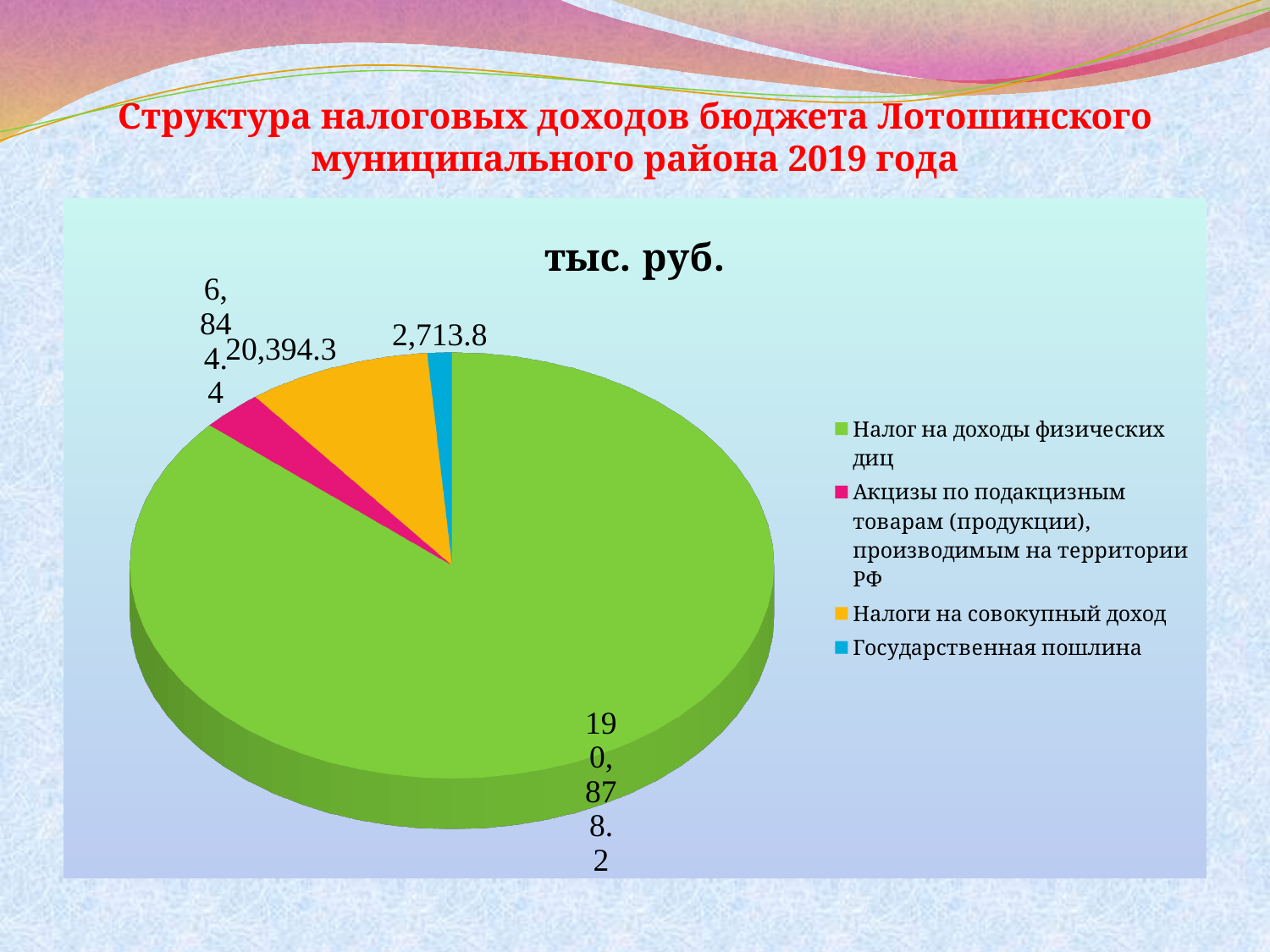
What is the value for Налоги на совокупный доход? 20,394.3 Which category has the smallest slice of the pie? Государственная пошлина How many categories does the pie chart show? 4 What is the title of the chart? тыс. руб. What is the difference between Налоги на совокупный доход and Акцизы по подакцизным товарам? 13,549.9 Which is larger: Налоги на совокупный доход or Акцизы по подакцизным товарам? Налоги на совокупный доход What is the value for Налог на доходы физических лиц? 190,878.2 What is the difference between Акцизы по подакцизным товарам and Государственная пошлина? 4,130.6 What is the value for Государственная пошлина? 2,713.8 What kind of chart is shown on the slide? Pie chart What is the value for Акцизы по подакцизным товарам (продукции), производимым на территории РФ? 6,844.4 Which category has the largest slice of the pie? Налог на доходы физических лиц